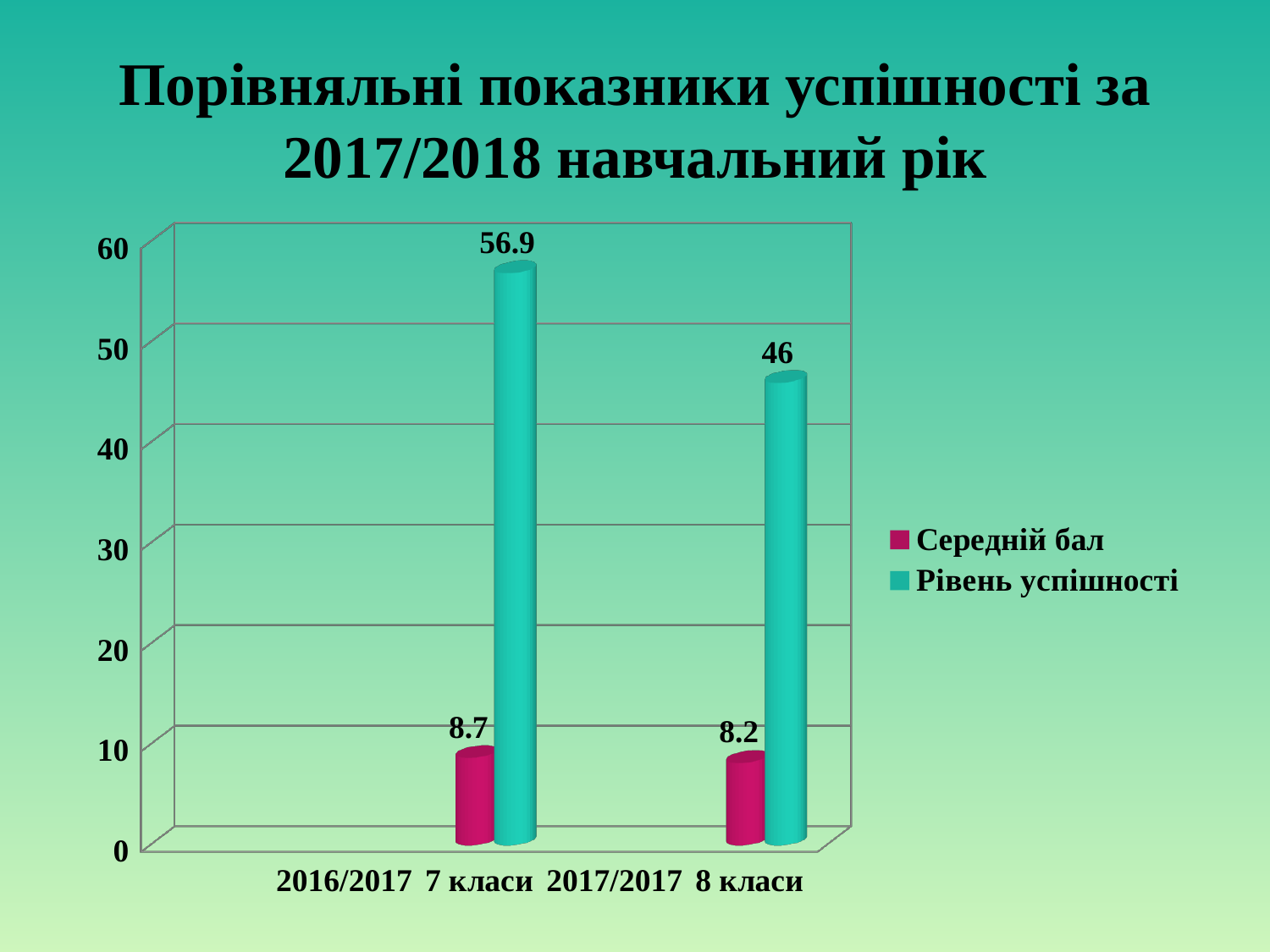
What kind of chart is shown on the slide? bar chart What is the value of Середній бал for 2017/2017 8 класи? 8.2 Which is larger: Середній бал for 2016/2017 7 класи or Середній бал for 2017/2017 8 класи? 2016/2017 7 класи What is the value of Рівень успішності for 2017/2017 8 класи? 46 Which category has the higher Рівень успішності? 2016/2017 7 класи What is the difference in Рівень успішності between 2016/2017 7 класи and 2017/2017 8 класи? 10.9 What is the value of Середній бал for 2016/2017 7 класи? 8.7 Is the value of Рівень успішності for 2017/2017 8 класи greater or less than 50? less What is the difference in Середній бал between 2016/2017 7 класи and 2017/2017 8 класи? 0.5 What is the value of Рівень успішності for 2016/2017 7 класи? 56.9 How many series does the legend list? 2 How many categories are shown on the x axis? 2